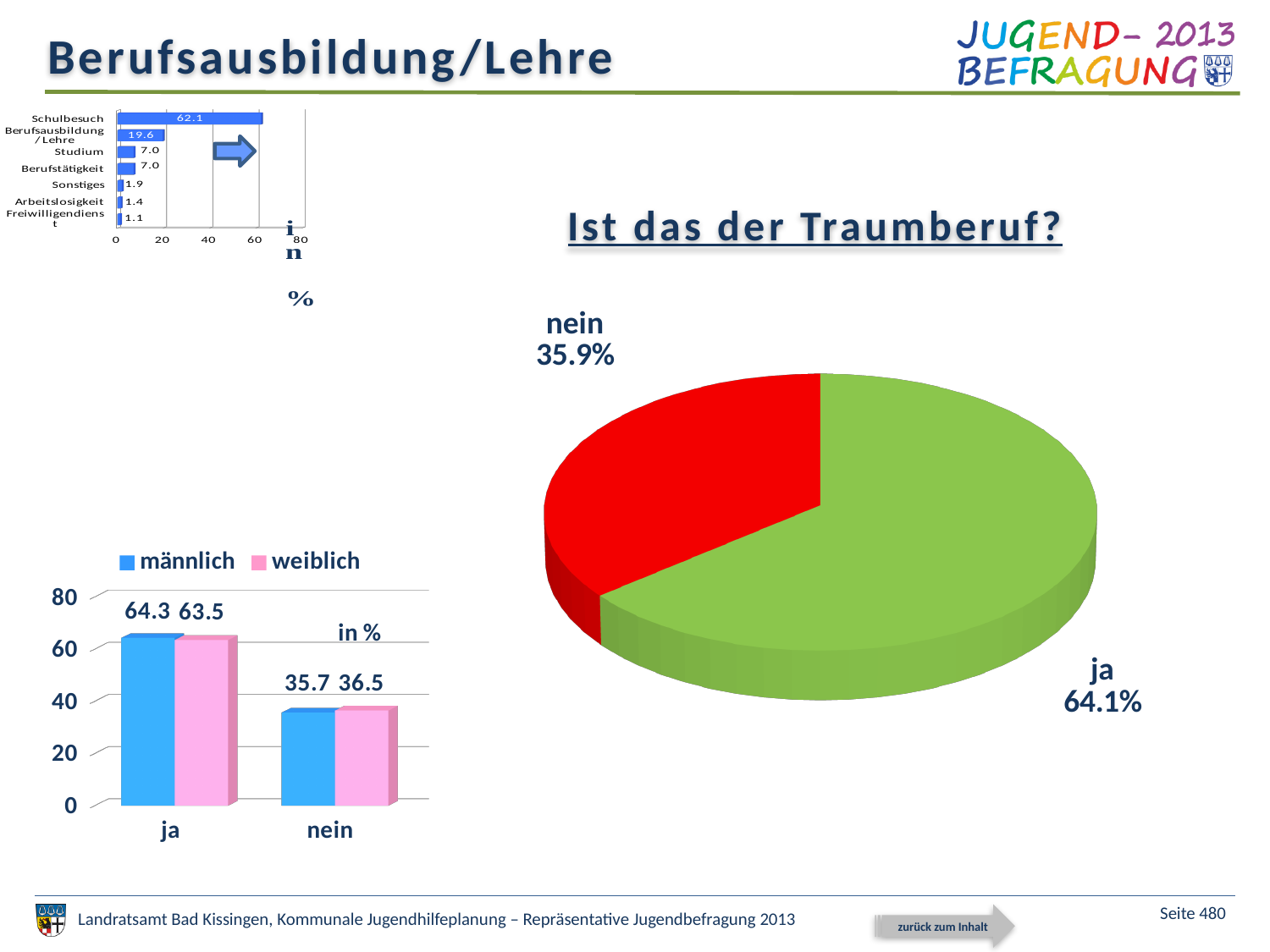
In the bar chart at the bottom left, how many series does the legend list? 2 In the bar chart at the bottom left, which series has the higher value in the 'nein' category? weiblich What kind of chart is the chart titled 'Ist das der Traumberuf?'? pie chart In the bar chart at the bottom left, what is the value for 'männlich' in the 'ja' category? 64.3 In the bar chart at the bottom left, what is the value for 'weiblich' in the 'nein' category? 36.5 In the small bar chart at the top left, what is the value for 'Schulbesuch'? 62.1 In the pie chart 'Ist das der Traumberuf?', what share is labelled 'ja'? 64.1% In the small bar chart at the top left, how many categories are shown? 7 In the bar chart at the bottom left, what is the difference between the 'männlich' and 'weiblich' values for 'ja'? 0.8 In the small bar chart at the top left, which category has the lowest value? Freiwilligendienst In the pie chart 'Ist das der Traumberuf?', which slice is larger, 'ja' or 'nein'? ja In the pie chart 'Ist das der Traumberuf?', what share is labelled 'nein'? 35.9%